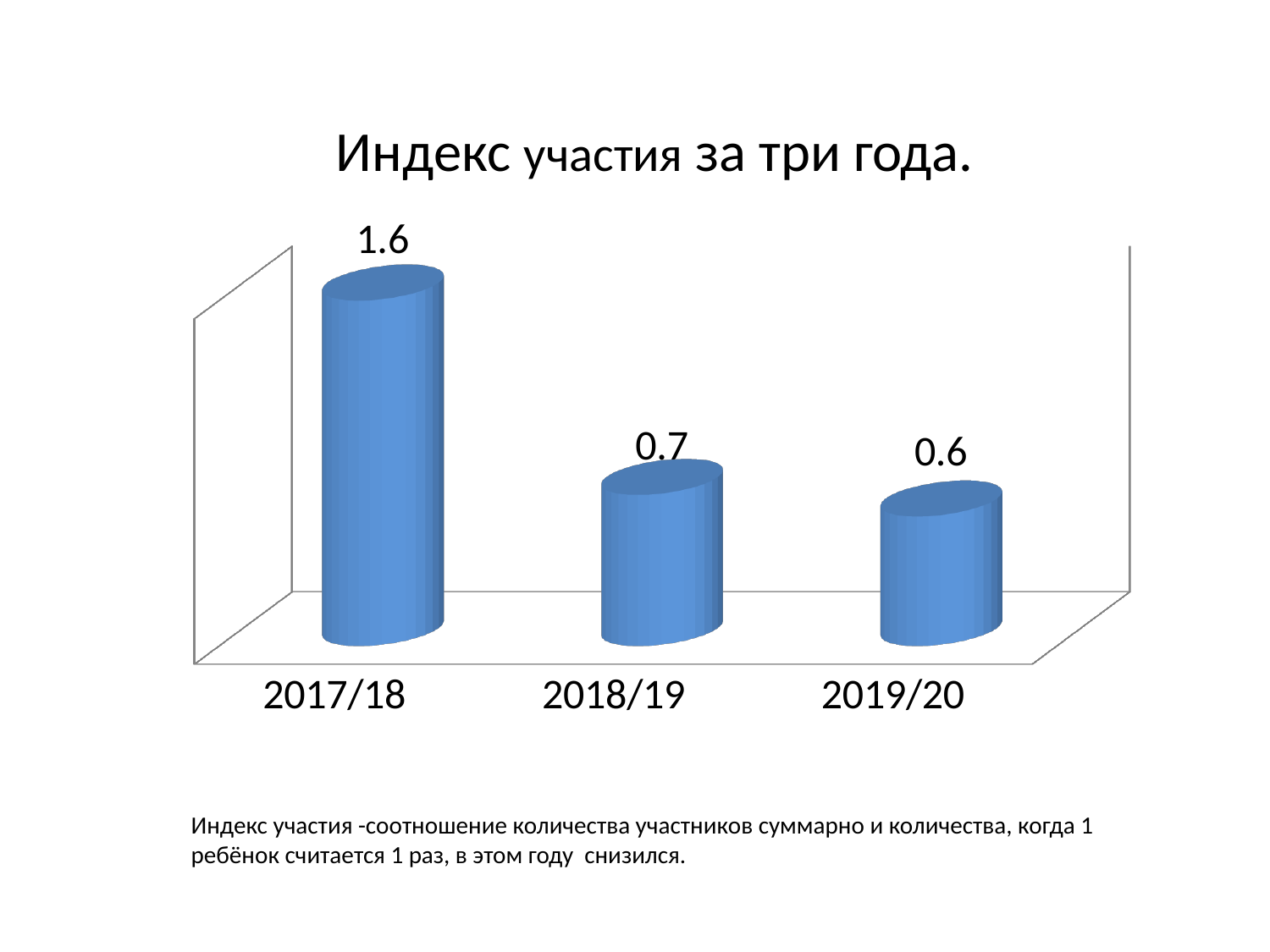
What is the difference between the values for 2017/18 and 2018/19? 0.9 What is the value for 2018/19? 0.7 Which year has the lowest value? 2019/20 Which year has the highest value? 2017/18 What is the title of the chart? Индекс участия за три года. Do the values rise or fall from 2017/18 to 2019/20? fall What kind of chart is this? bar chart Which is larger, the value for 2017/18 or the value for 2019/20? 2017/18 What is the value for 2019/20? 0.6 How many categories are shown on the x axis? 3 What is the value for 2017/18? 1.6 What is the difference between the values for 2018/19 and 2019/20? 0.1